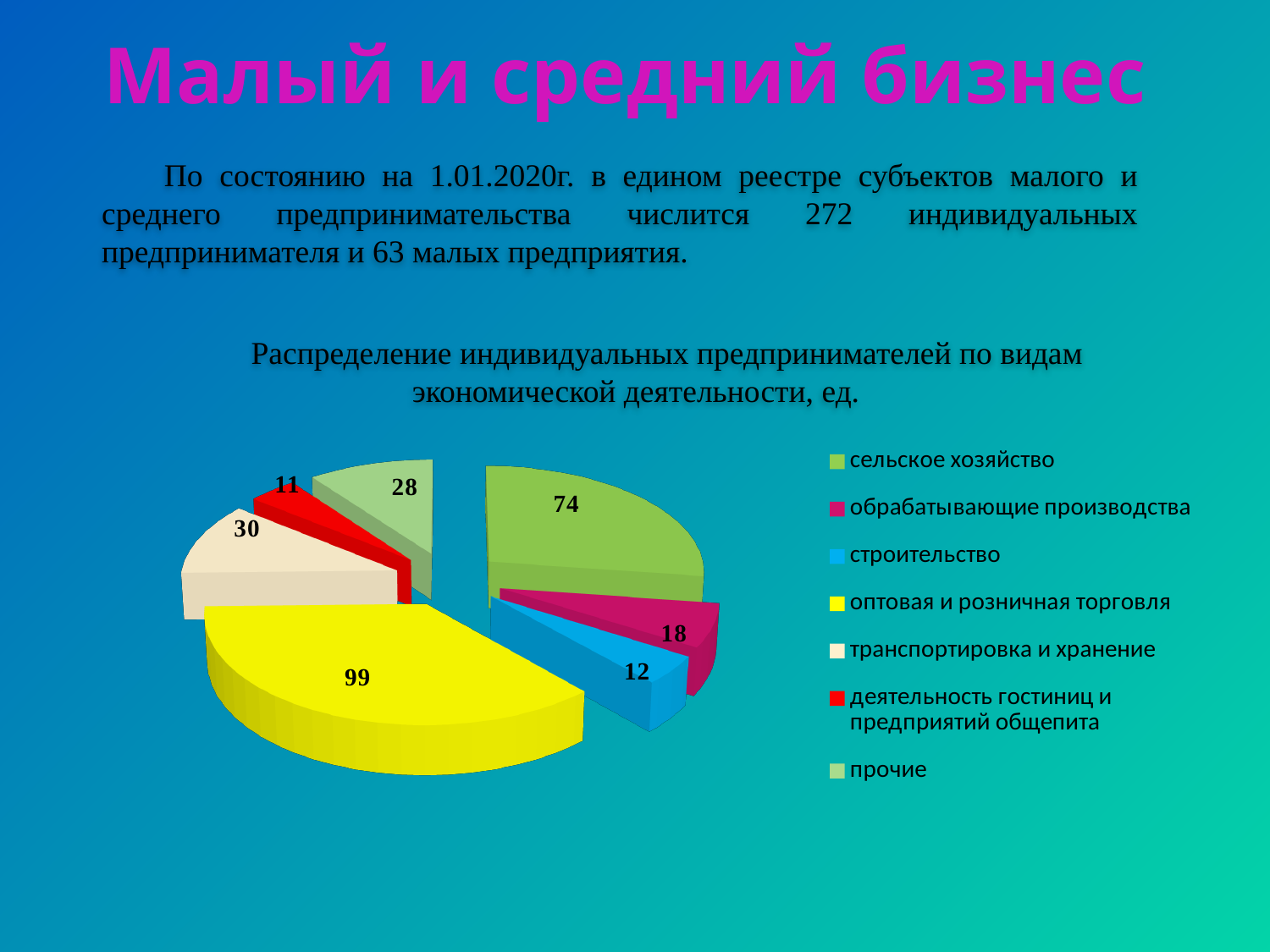
What type of chart is shown on the slide? Pie chart Which category has the smallest slice of the pie? деятельность гостиниц и предприятий общепита What is the total of all slices in the pie chart? 272 What is the value for деятельность гостиниц и предприятий общепита? 11 What is the difference between the values for оптовая и розничная торговля and сельское хозяйство? 25 What colour is the slice for оптовая и розничная торговля? Yellow What is the value for транспортировка и хранение? 30 What is the value for оптовая и розничная торговля? 99 Which is larger, the value for обрабатывающие производства or the value for строительство? обрабатывающие производства How many categories does the pie chart show? 7 Which category has the largest slice of the pie? оптовая и розничная торговля What is the value for сельское хозяйство? 74